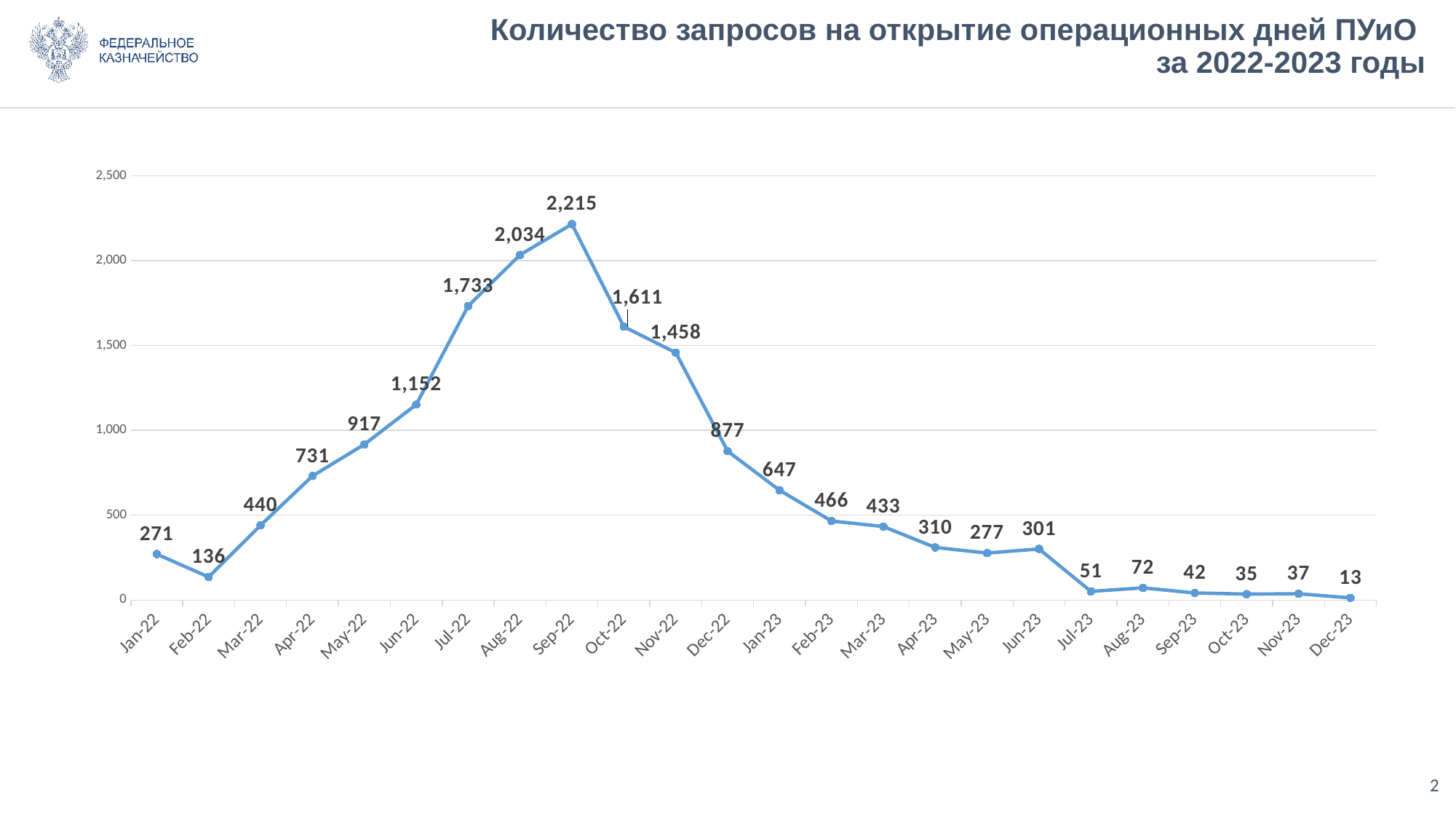
Which month has the lowest value? Dec-23 What is the difference between the values for Sep-22 and Aug-22? 181 Which month has the highest value? Sep-22 What is the value for Dec-23? 13 What is the title of the chart? Количество запросов на открытие операционных дней ПУиО за 2022-2023 годы Which is larger, the value for Oct-22 or the value for Nov-22? Oct-22 What is the value for Sep-22? 2,215 What is the value for Jan-22? 271 Is the value for Jun-22 greater or less than 1,000? greater What kind of chart is shown on the slide? line chart Do the values rise or fall from Sep-22 to Dec-23? fall How many data points are plotted on the chart? 24